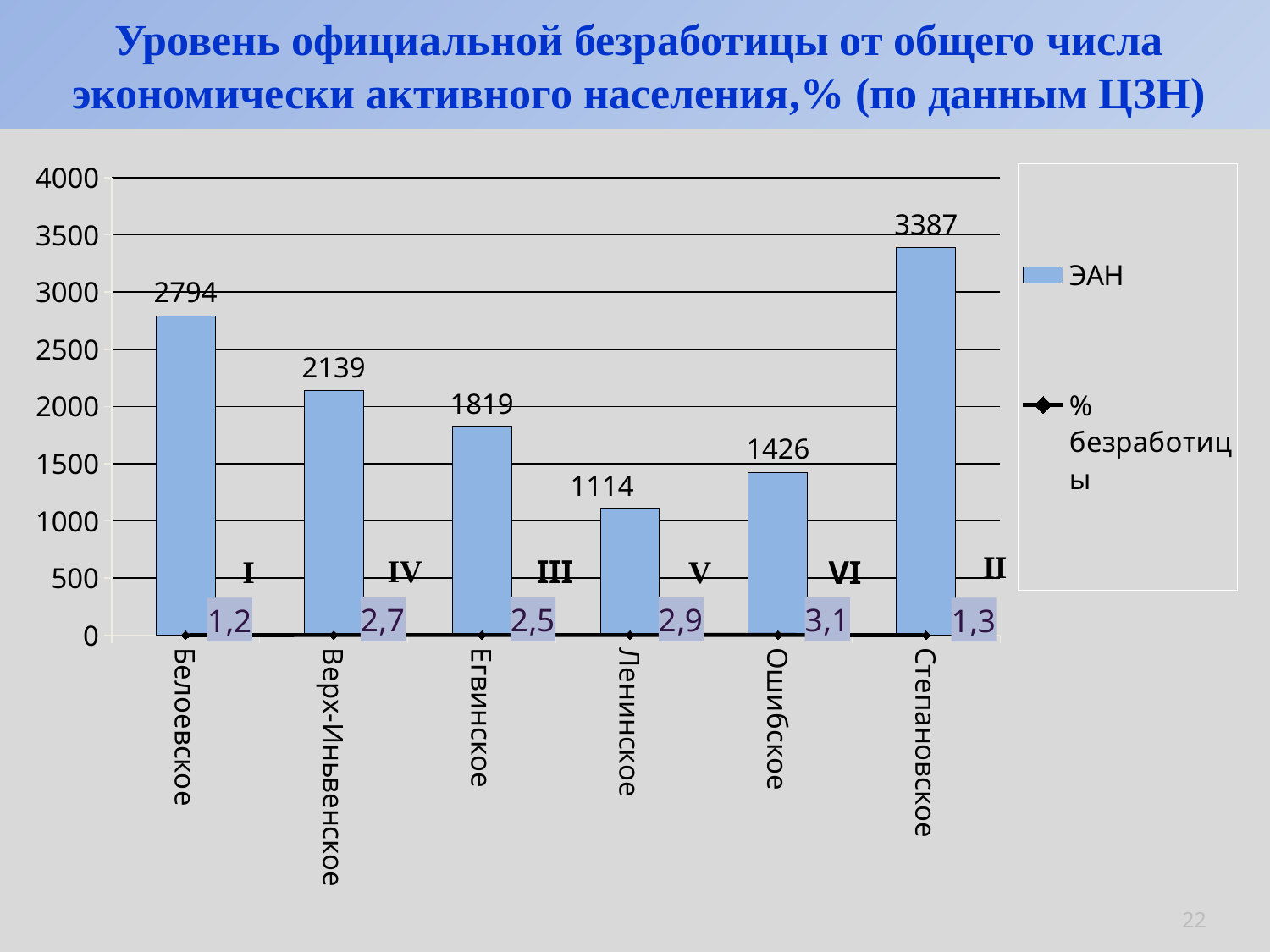
What are the two series named in the legend? ЭАН and % безработицы What is the ЭАН value for Ленинское? 1114 What is the difference in ЭАН between Степановское and Белоевское? 593 What is the % безработицы value for Белоевское? 1,2 How many series does the legend list? 2 What kind of chart is used for the ЭАН series? bar chart Which has a larger ЭАН value, Верх-Иньвенское or Егвинское? Верх-Иньвенское Which category has the highest ЭАН value? Степановское How many categories are shown on the x axis? 6 What is the ЭАН value for Степановское? 3387 What is the % безработицы value for Ошибское? 3,1 Which category has the lowest % безработицы value? Белоевское